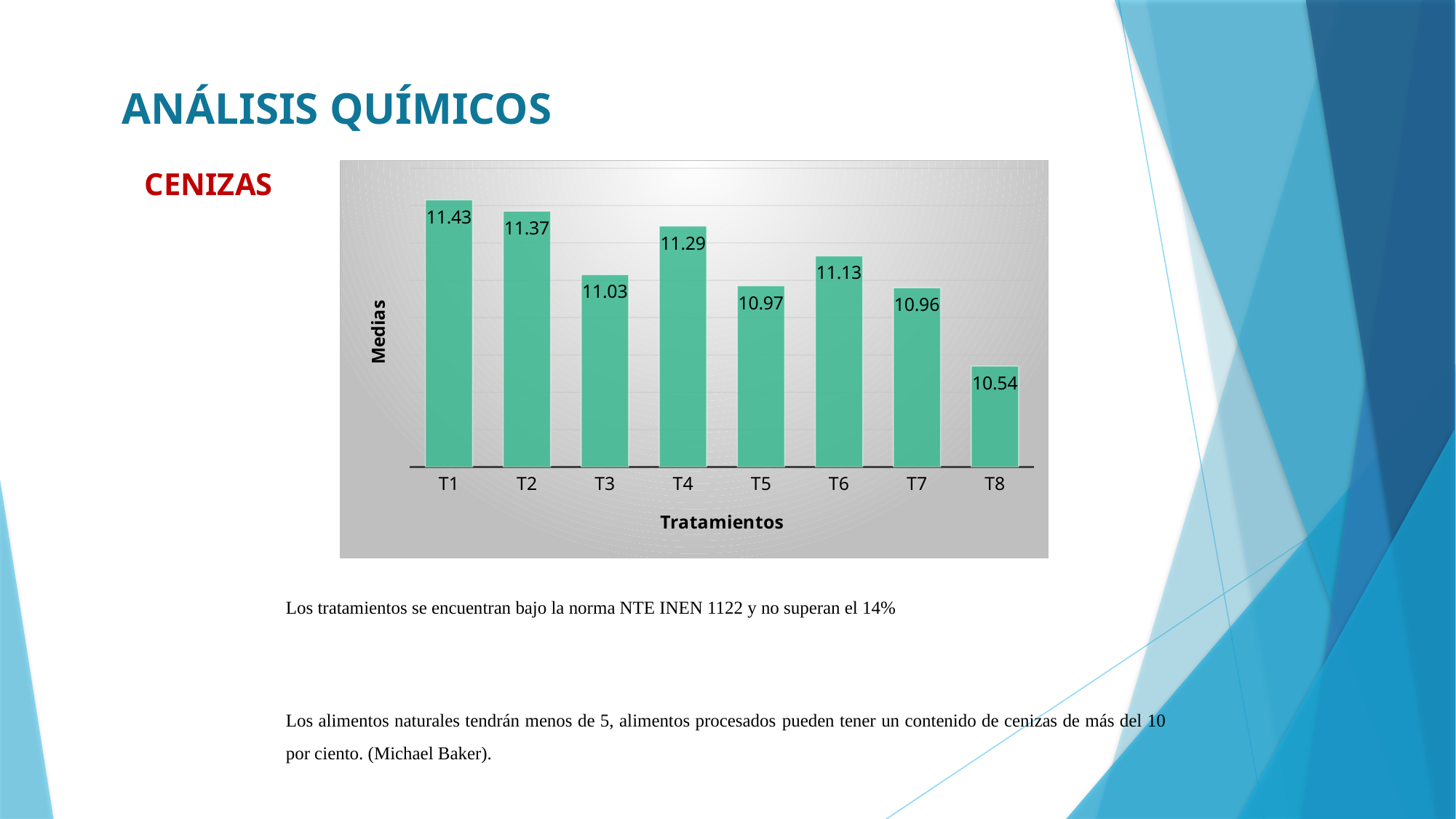
What is the value for T6? 11.13 What is the difference between the values for T1 and T8? 0.89 What is the label of the x axis? Tratamientos What is the difference between the values for T2 and T3? 0.34 How many treatments are shown on the x axis? 8 Which treatment has the lowest value? T8 What is the value for T8? 10.54 What is the value for T4? 11.29 What is the value for T1? 11.43 Which is larger, the value for T4 or the value for T5? T4 What kind of chart is shown on the slide? Bar chart Which treatment has the highest value? T1